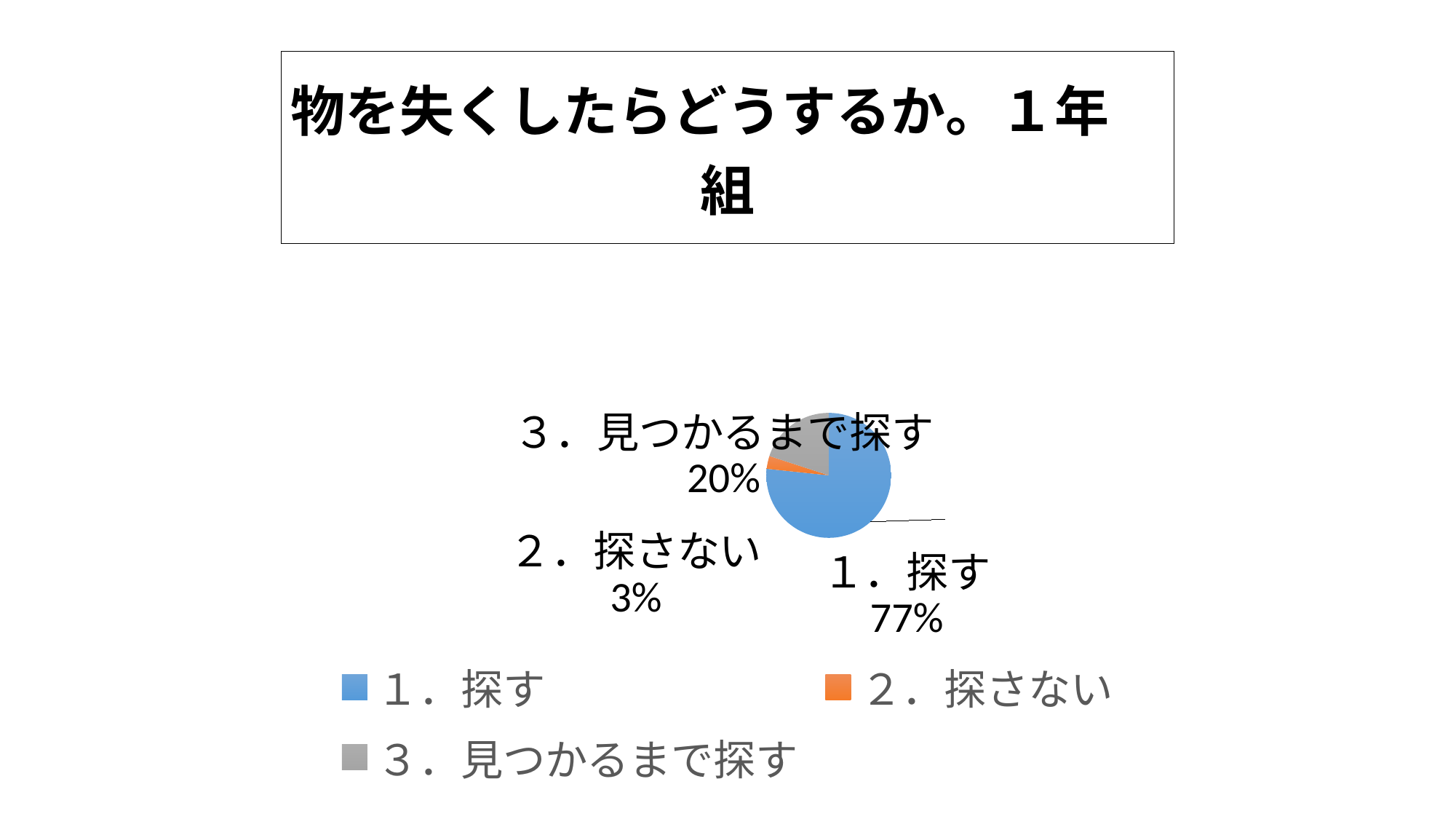
What percentage of the pie is labelled 3．見つかるまで探す? 20% What is the difference in percentage points between 1．探す and 3．見つかるまで探す? 57 Which category has the smallest share of the pie? 2．探さない What colour is the slice for 2．探さない? orange Which is larger, the share for 3．見つかるまで探す or the share for 2．探さない? 3．見つかるまで探す What kind of chart is shown on the slide? pie chart How many categories are shown in the pie chart? 3 What is the title of the chart? 物を失くしたらどうするか。１年組 What percentage of the pie is labelled 1．探す? 77% How many entries does the legend list? 3 Which category has the largest share of the pie? 1．探す What percentage of the pie is labelled 2．探さない? 3%